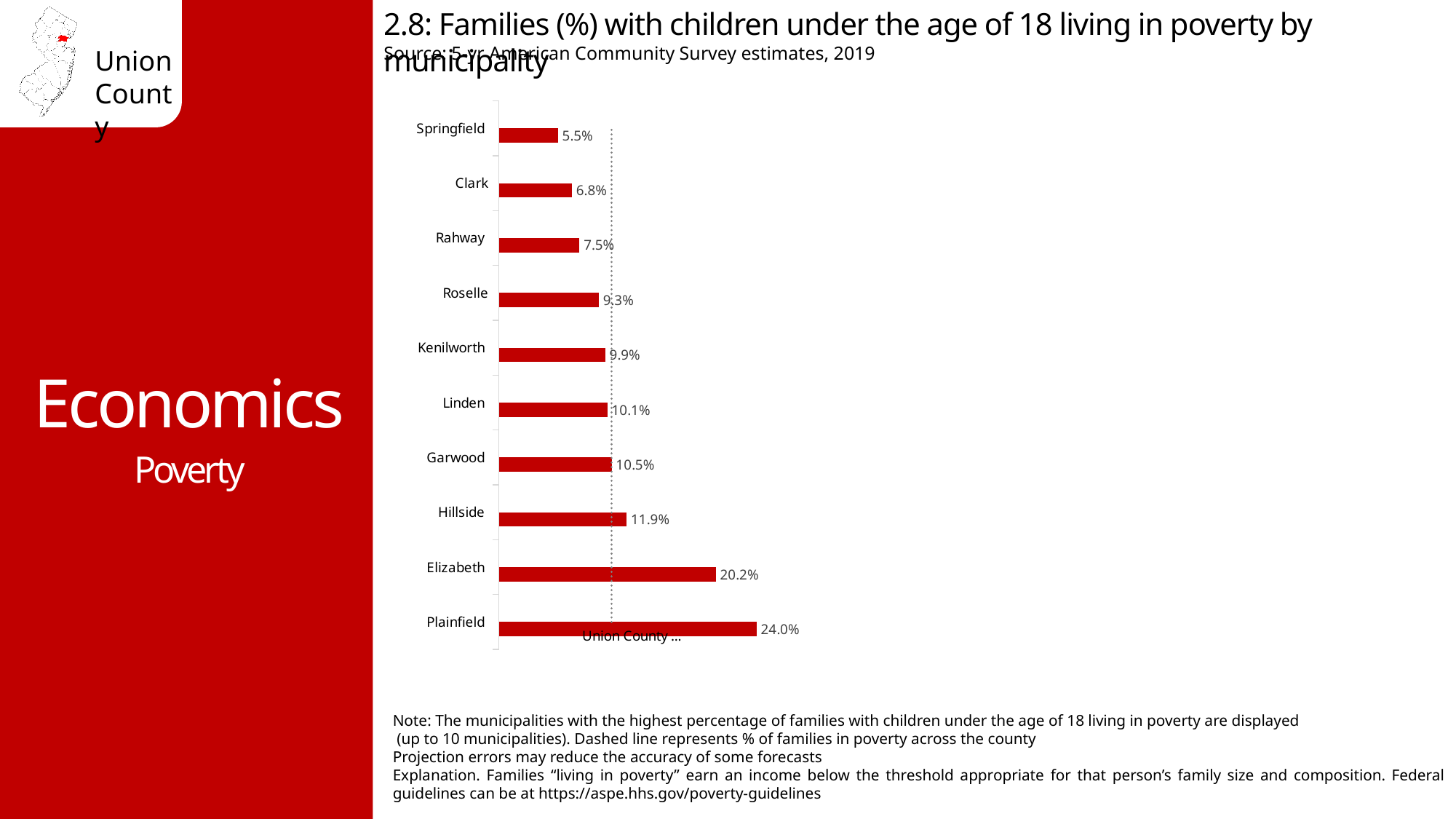
What does the dashed vertical line in the chart represent? % of families in poverty across the county What is the difference between the values for Plainfield and Elizabeth? 3.8% Which is larger, the value for Rahway or the value for Roselle? Roselle What is the value for Elizabeth? 20.2% Which municipality has the lowest value? Springfield What is the difference between the values for Hillside and Garwood? 1.4% Which municipality has the highest value? Plainfield What is the value for Springfield? 5.5% What kind of chart is shown on the slide? Bar chart What is the value for Plainfield? 24.0% How many municipalities are shown in the chart? 10 What is the value for Kenilworth? 9.9%